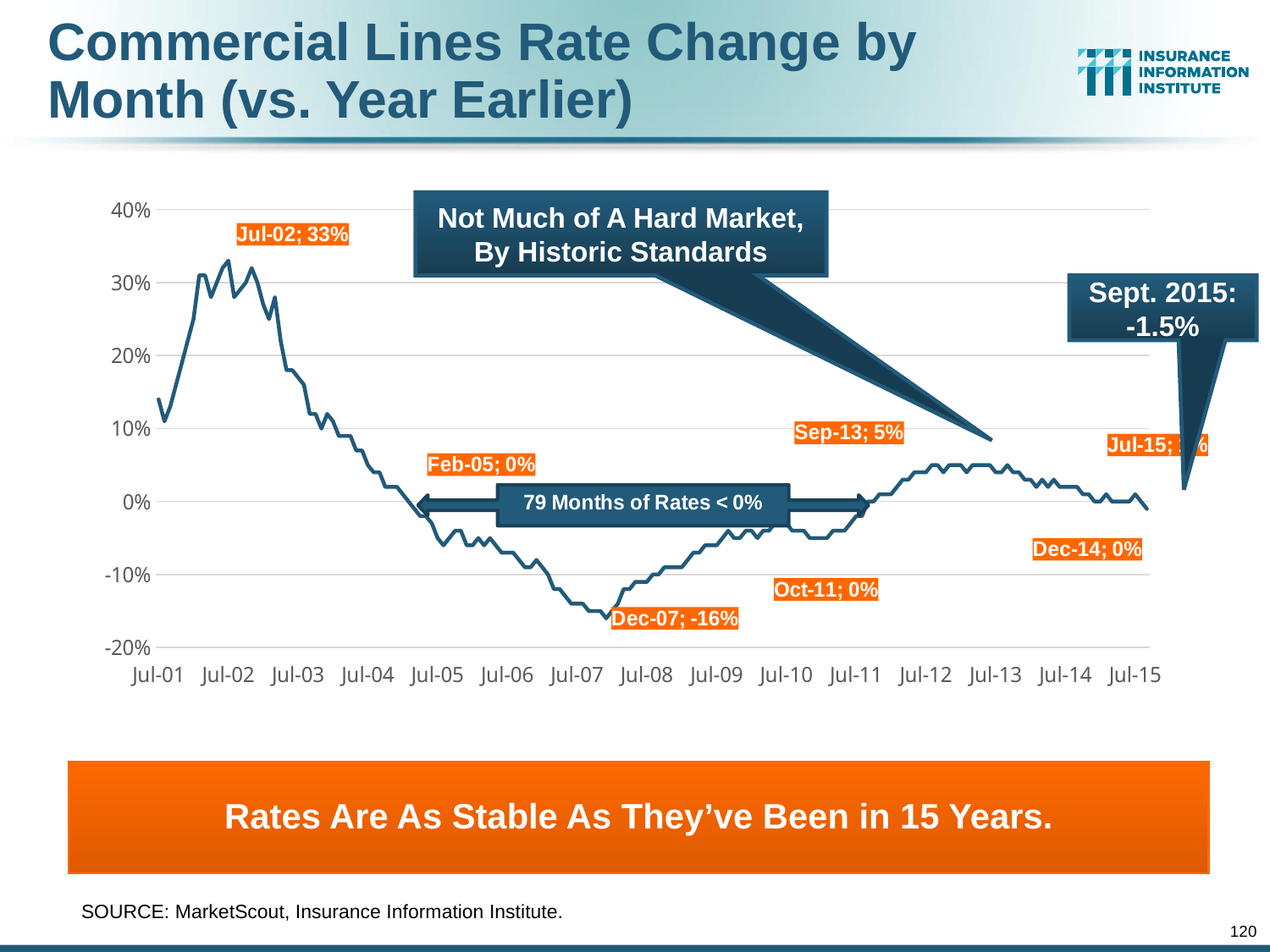
Is the rate change for Jul-01 greater or less than 10%? greater What is the labeled rate change for Dec-07? -16% What kind of chart is shown on the slide? Line chart According to the callout, what was the rate change in Sept. 2015? -1.5% What is the labeled rate change for Jul-02? 33% What is the labeled rate change for Sep-13? 5% What is the difference between the labeled rate change for Jul-02 and Dec-07? 49 percentage points What is the labeled rate change for Feb-05? 0% Which labeled month has the highest rate change? Jul-02 What is the chart's title? Commercial Lines Rate Change by Month (vs. Year Earlier) Which labeled month has the lowest rate change? Dec-07 Which is larger, the labeled rate change for Jul-02 or for Sep-13? Jul-02